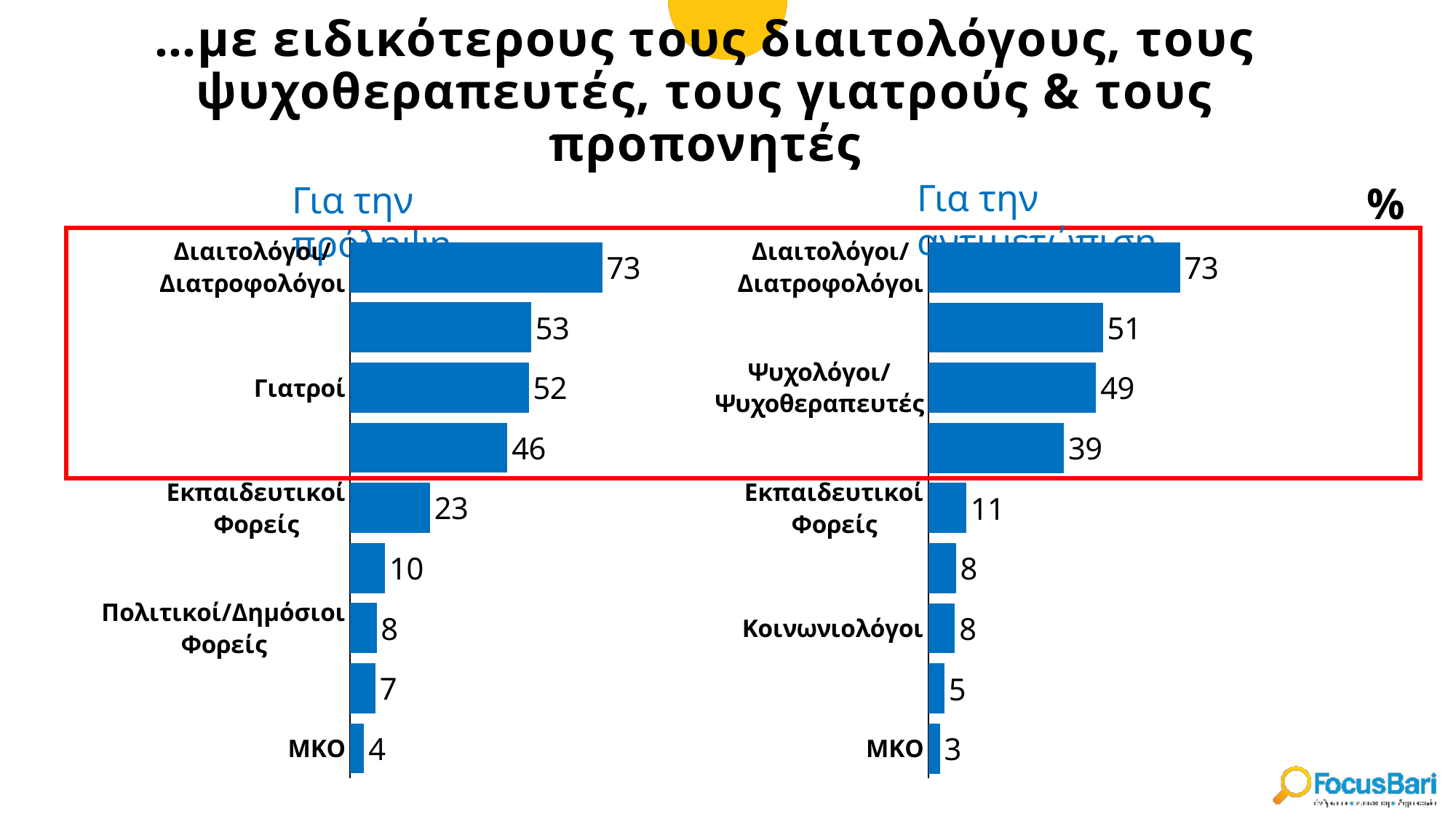
In the right chart, what is the value for Κοινωνιολόγοι? 8 In the left chart, what is the value for Εκπαιδευτικοί Φορείς? 23 What is the difference between the values for Διαιτολόγοι/Διατροφολόγοι and Γιατροί in the left chart? 21 Which is larger: the value for ΜΚΟ in the left chart or in the right chart? Left chart (4) What kind of chart is the left chart? Bar chart What is the difference between the value for Εκπαιδευτικοί Φορείς in the left chart and in the right chart? 12 In the right chart, what is the value for Ψυχολόγοι/Ψυχοθεραπευτές? 49 In the left chart, what is the value for Γιατροί? 52 In the left chart, which category has the highest value? Διαιτολόγοι/Διατροφολόγοι How many bars does the right chart have? 9 In the left chart, what is the value for Διαιτολόγοι/Διατροφολόγοι? 73 In the right chart, which category has the lowest value? ΜΚΟ